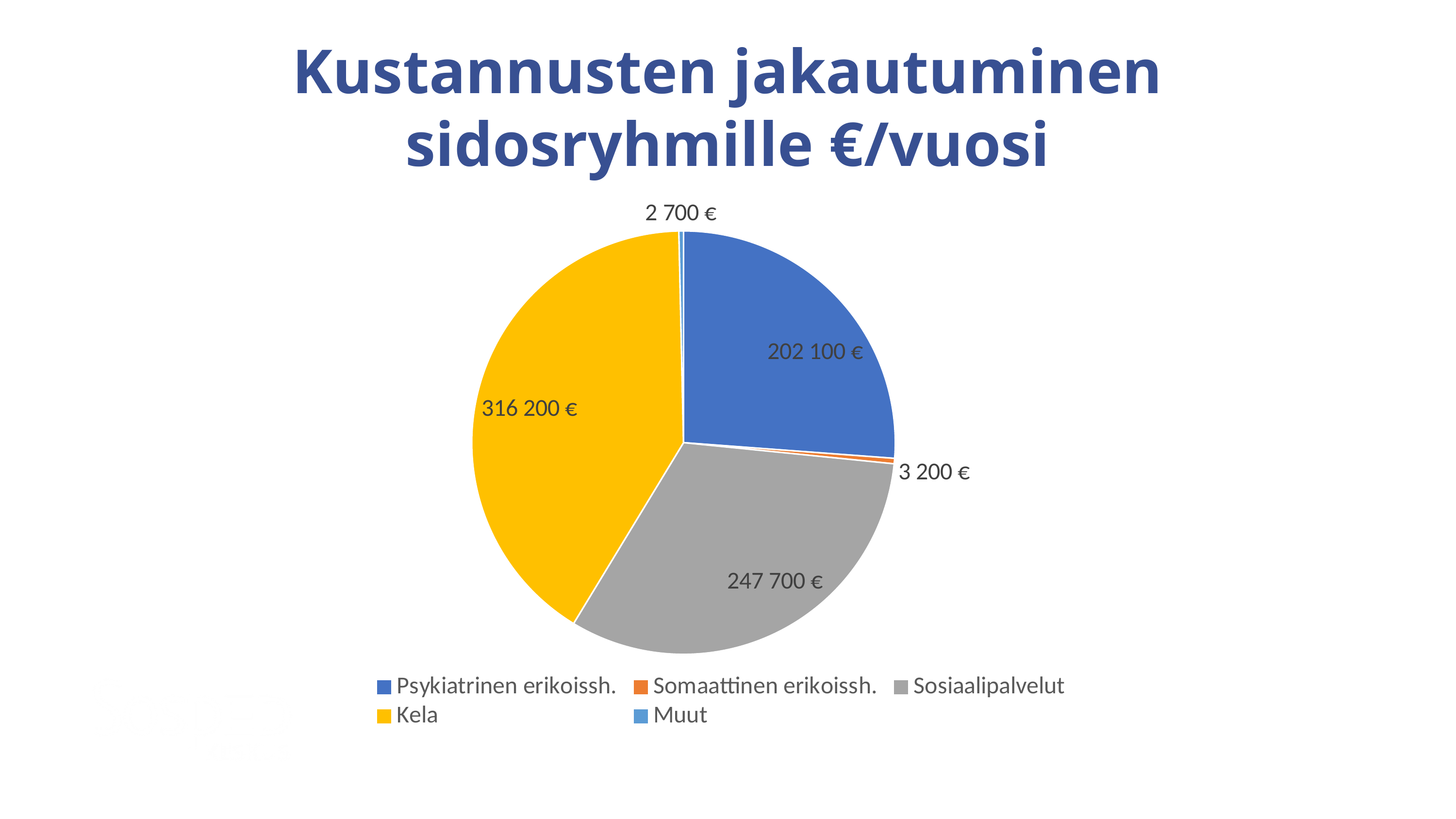
What type of chart is shown on the slide? Pie chart What is the title of the chart? Kustannusten jakautuminen sidosryhmille €/vuosi Which category has the smallest share of the pie? Muut Which is larger, the value for Sosiaalipalvelut or the value for Psykiatrinen erikoissh.? Sosiaalipalvelut Which category has the largest share of the pie? Kela What is the value for Psykiatrinen erikoissh.? 202 100 € What is the difference between the values for Kela and Sosiaalipalvelut? 68 500 € What is the value for Muut? 2 700 € What is the value for Sosiaalipalvelut? 247 700 € What is the value for Somaattinen erikoissh.? 3 200 € What is the value for Kela? 316 200 € How many categories does the pie chart have? 5